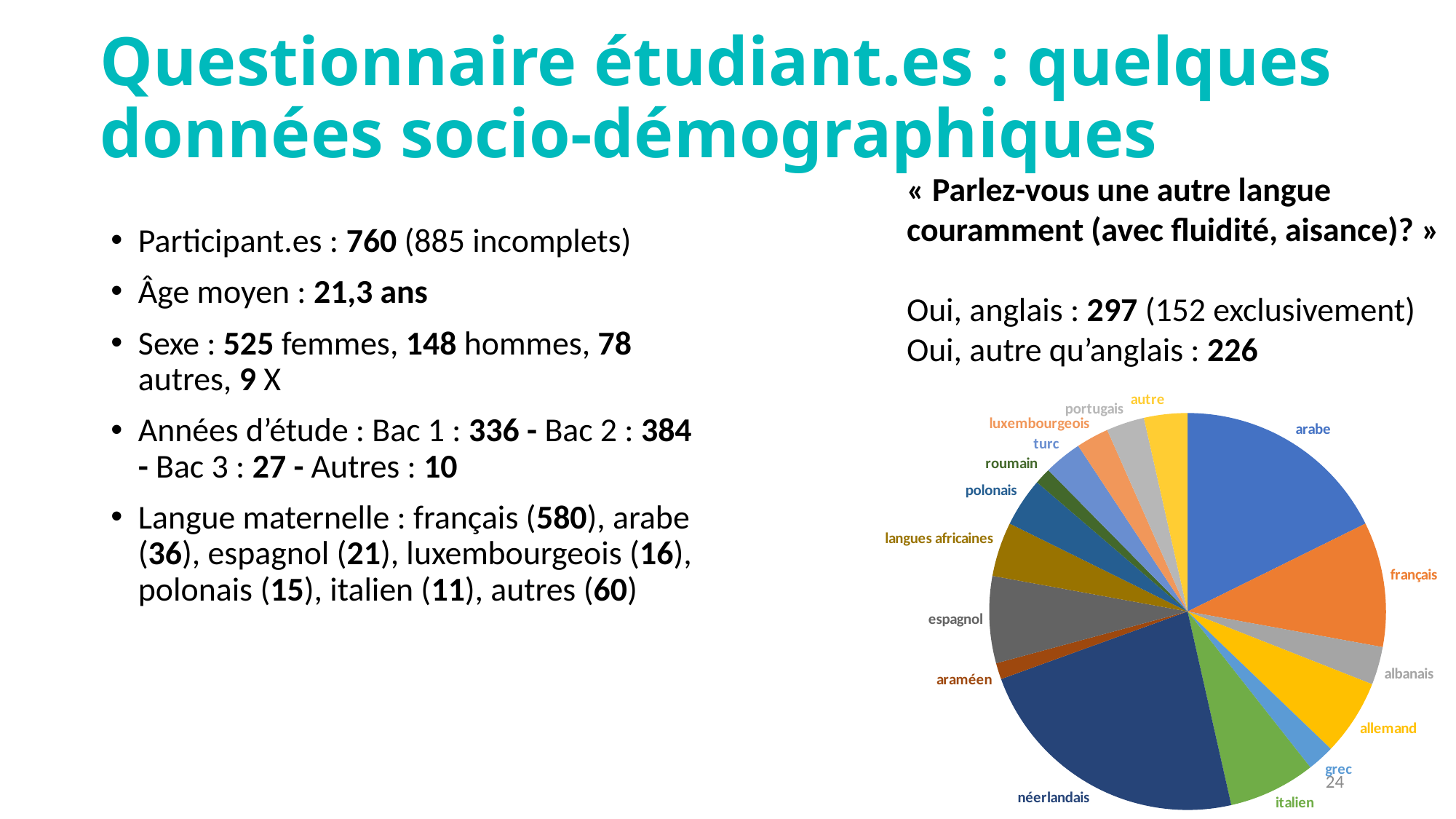
In the pie chart, which slice is larger, arabe or albanais? arabe What kind of chart is shown on the slide? pie chart Which survey question does the pie chart relate to? « Parlez-vous une autre langue couramment (avec fluidité, aisance)? » In the pie chart, which slice is larger, arabe or français? arabe How many slices does the pie chart have? 16 In the pie chart, which slice is larger, italien or grec? italien Which language has the largest slice in the pie chart? néerlandais Which language is represented by the orange slice next to arabe in the pie chart? français